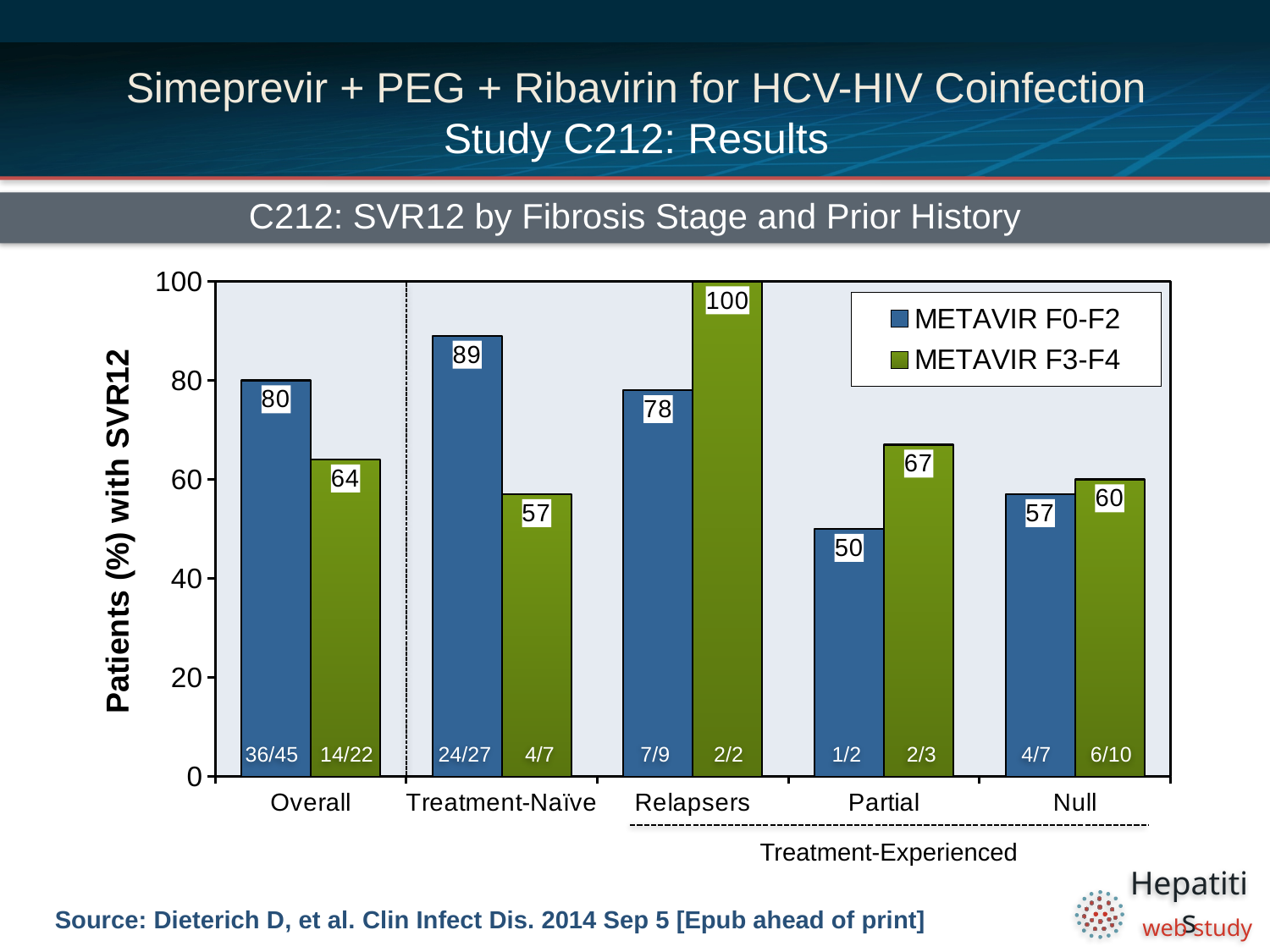
How many categories are shown on the x axis? 5 What kind of chart is shown on the slide? Bar chart What is the difference between the METAVIR F0-F2 and METAVIR F3-F4 SVR12 rates in the Treatment-Naïve group? 32 What is the label of the y axis? Patients (%) with SVR12 What is the SVR12 rate for METAVIR F0-F2 patients in the Overall group? 80 In the Relapsers group, which series has the higher SVR12 rate, METAVIR F0-F2 or METAVIR F3-F4? METAVIR F3-F4 Which category has the highest SVR12 rate for METAVIR F3-F4 patients? Relapsers How many series does the legend list? 2 What is the SVR12 rate for METAVIR F0-F2 patients in the Partial group? 50 Which category has the lowest SVR12 rate for METAVIR F0-F2 patients? Partial Is the METAVIR F3-F4 value for the Overall group greater or less than 60? greater What is the SVR12 rate for METAVIR F3-F4 patients in the Treatment-Naïve group? 57